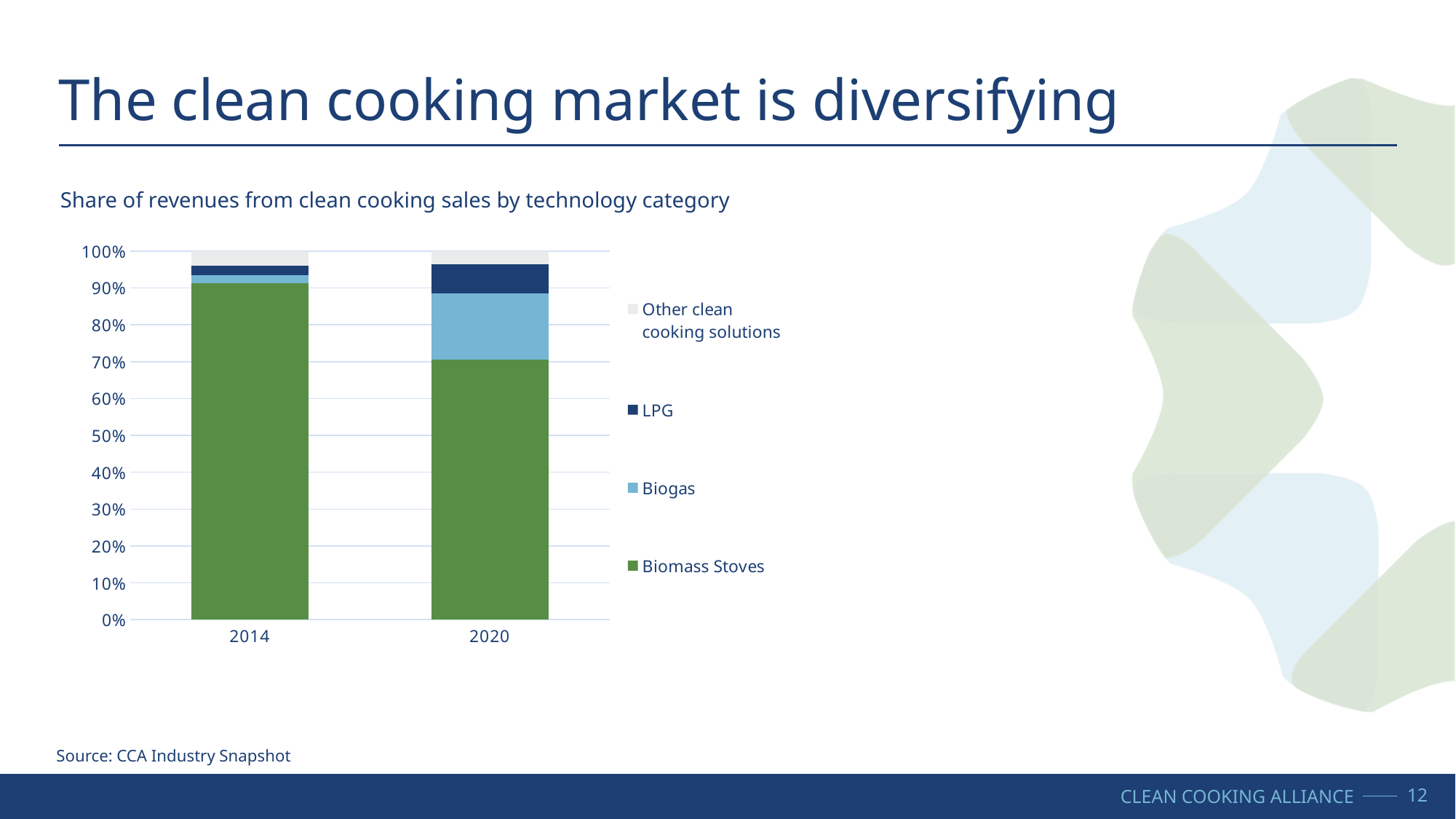
Is the Biomass Stoves share in 2014 greater or less than 90%? greater Does the Biomass Stoves share rise or fall from 2014 to 2020? fall What is the total of the stacked bar for 2020? 100% Which year has the larger LPG share, 2014 or 2020? 2020 Which year has the larger Biomass Stoves share, 2014 or 2020? 2014 What kind of chart is shown on the slide? Stacked bar chart How many years are shown on the x axis of the chart? 2 Is the Biomass Stoves share in 2020 greater or less than 80%? less How many series does the chart's legend list? 4 Is the Biogas share in 2014 greater or less than 10%? less What is the subtitle describing what the chart shows? Share of revenues from clean cooking sales by technology category